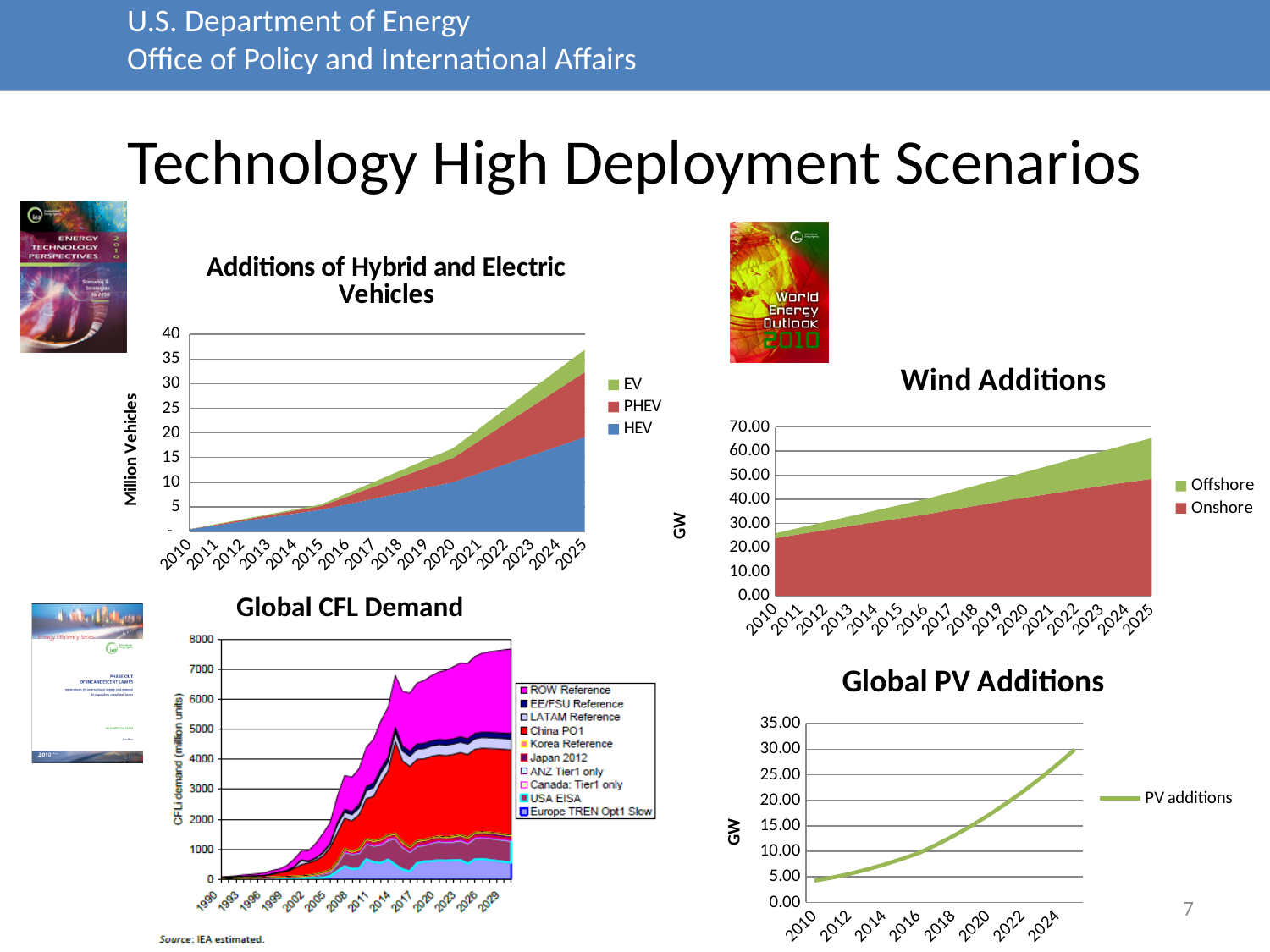
What is the y-axis label of the "Additions of Hybrid and Electric Vehicles" chart? Million Vehicles In the "Global PV Additions" chart, is the value for 2024 greater or less than 25.00 GW? greater In the "Wind Additions" chart, is the total wind addition in 2025 greater or less than 60.00 GW? greater What kind of chart is the "Global PV Additions" chart? line chart How many series does the legend of the "Wind Additions" chart list? 2 In the "Additions of Hybrid and Electric Vehicles" chart, is the total for 2025 greater or less than 30 million vehicles? greater How many series does the legend of the "Additions of Hybrid and Electric Vehicles" chart list? 3 In the "Global PV Additions" chart, do PV additions rise or fall from 2010 to 2024? rise How many series does the legend of the "Global CFL Demand" chart list? 10 How many years are shown on the x axis of the "Wind Additions" chart? 16